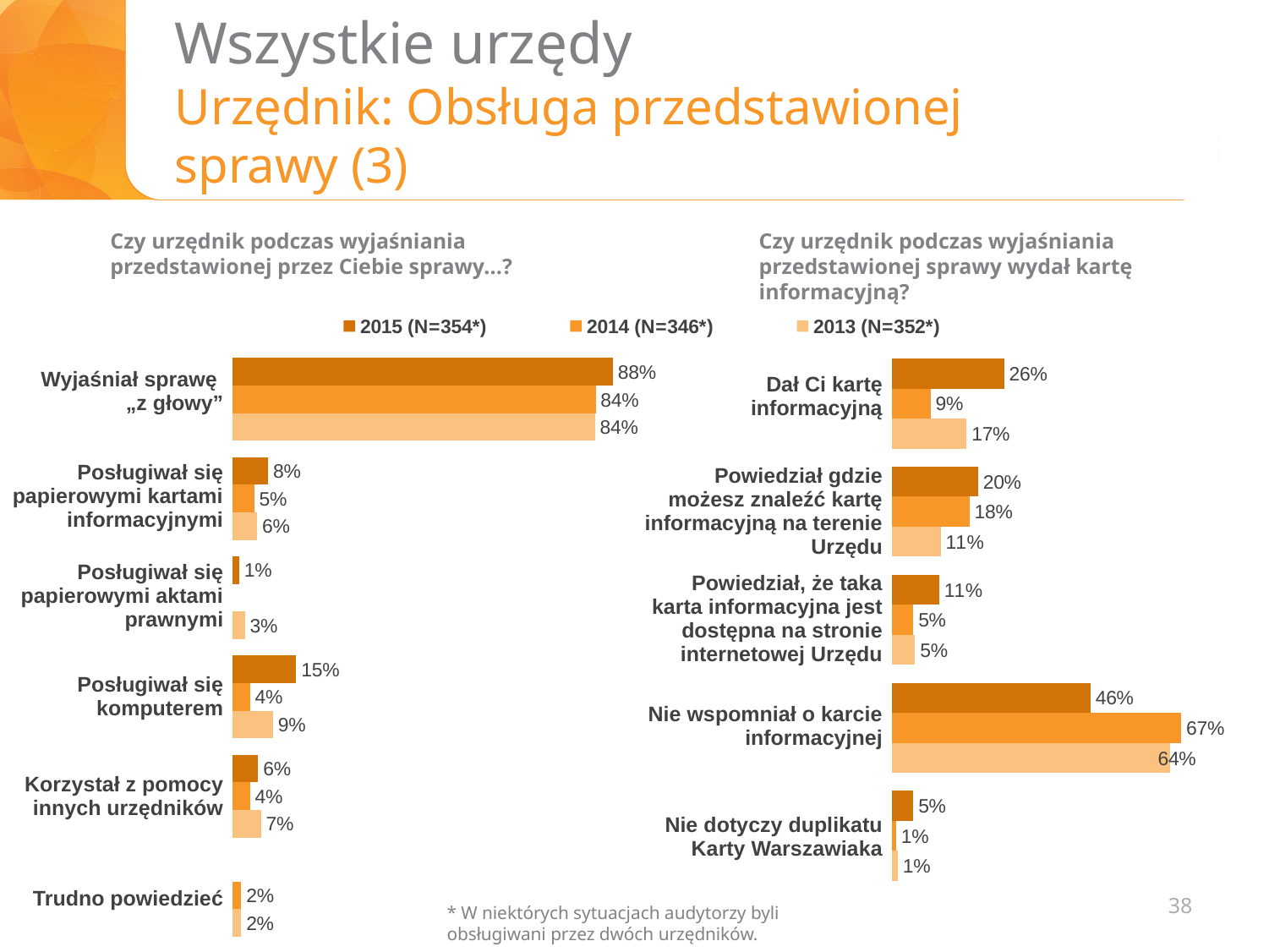
In the left chart, what is the 2015 value for "Wyjaśniał sprawę „z głowy”"? 88% In the right chart, what is the difference between the 2014 and 2015 values for "Nie wspomniał o karcie informacyjnej"? 21 percentage points In the left chart, which category has the highest 2015 value? Wyjaśniał sprawę „z głowy” How many series does the legend list? 3 What type of chart is used on this slide? Bar chart In the left chart, what is the 2014 value for "Posługiwał się komputerem"? 4% In the right chart, what is the 2013 value for "Dał Ci kartę informacyjną"? 17% In the right chart, which year has the lowest value for "Nie wspomniał o karcie informacyjnej"? 2015 In the right chart, what is the 2014 value for "Nie wspomniał o karcie informacyjnej"? 67% In the left chart, what is the difference between the 2015 and 2014 values for "Posługiwał się komputerem"? 11 percentage points In the left chart, what is the 2013 value for "Korzystał z pomocy innych urzędników"? 7% In the right chart, is the 2015 value for "Dał Ci kartę informacyjną" larger or smaller than the 2014 value? larger